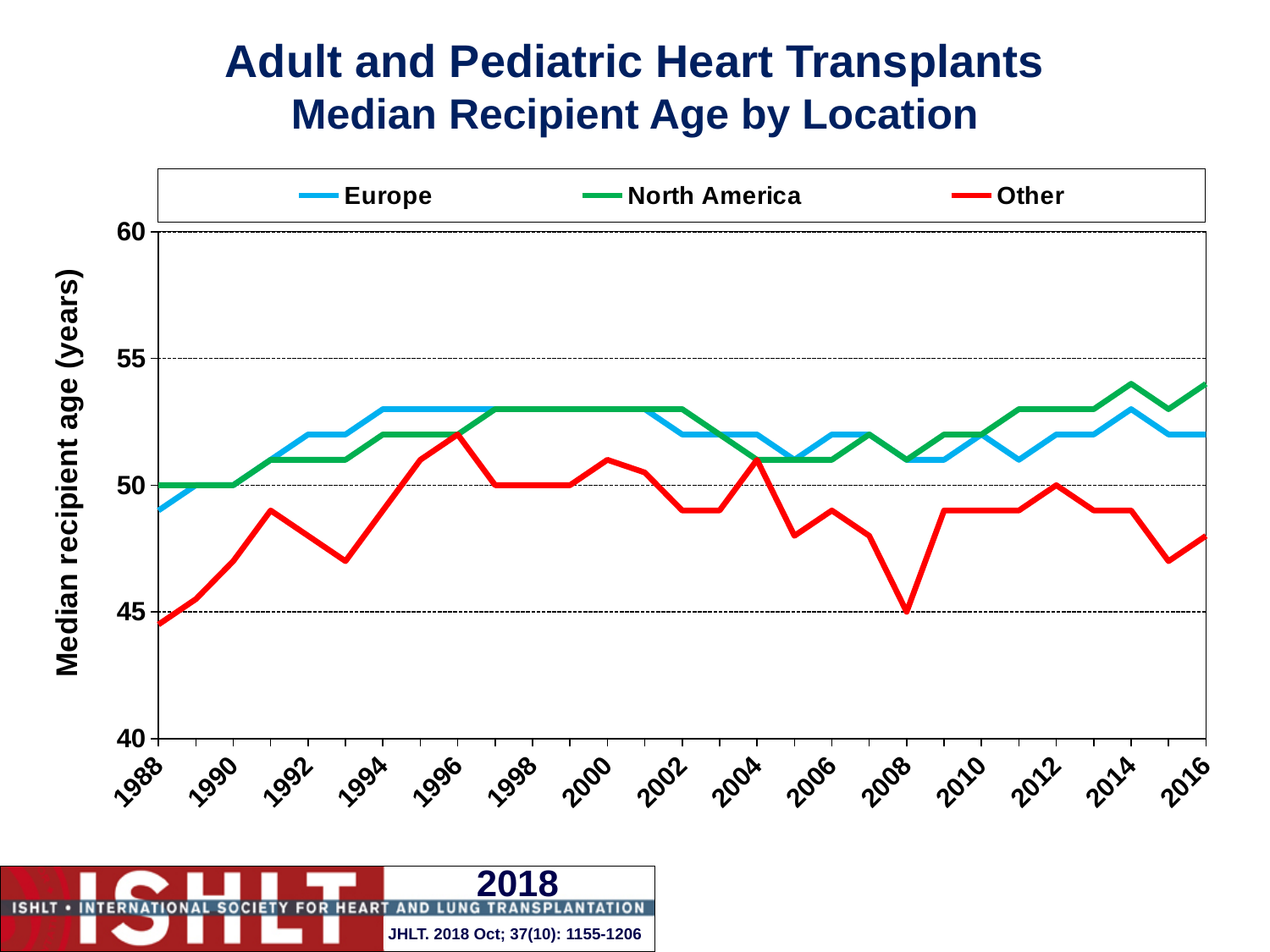
What is the label on the y axis? Median recipient age (years) What is the median recipient age for Other in 2012? 50 What is the median recipient age for Other in 2008? 45 What is the median recipient age for North America in 1988? 50 Is the value for Other in 1988 greater or less than 45? less Is the value for Europe in 2016 greater or less than 50? greater Is the value for North America in 2014 greater or less than 55? less In 2008, which series has the higher median recipient age, Europe or Other? Europe Does the Other series rise or fall from 2004 to 2008? fall What kind of chart is shown on the slide? line chart In which year is the Other series at its lowest value? 1988 How many series does the legend list? 3